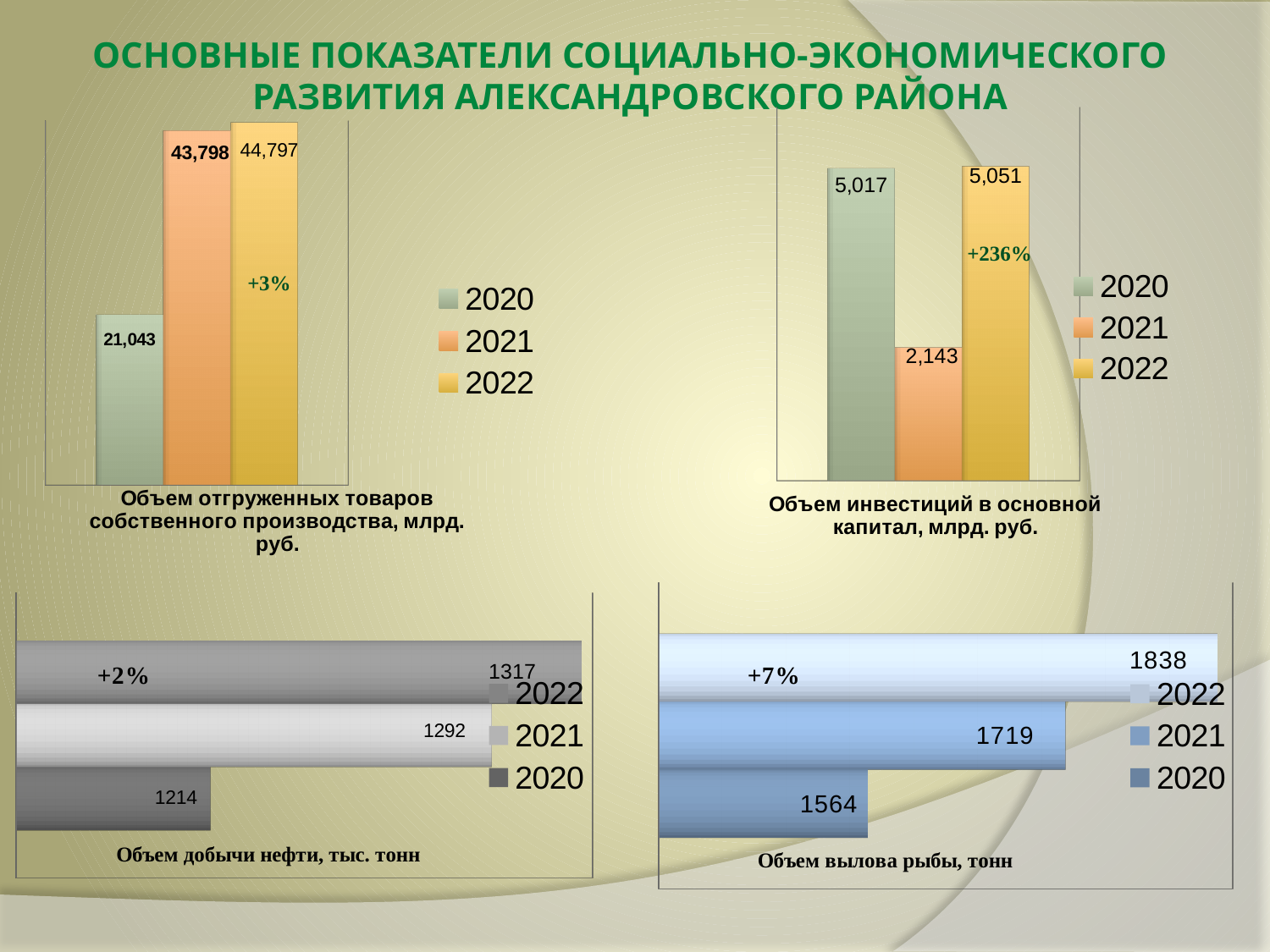
In the chart 'Объем добычи нефти, тыс. тонн', what is the value for 2020? 1214 In the chart 'Объем вылова рыбы, тонн', what is the value for 2022? 1838 In the chart 'Объем добычи нефти, тыс. тонн', what is the difference between the 2022 and 2021 values? 25 What kind of chart is 'Объем вылова рыбы, тонн'? bar chart In the chart 'Объем инвестиций в основной капитал, млрд. руб.', which year has the lowest value? 2021 In the chart 'Объем отгруженных товаров собственного производства, млрд. руб.', what is the value for 2021? 43,798 In the chart 'Объем вылова рыбы, тонн', what is the difference between the 2021 and 2020 values? 155 In the chart 'Объем инвестиций в основной капитал, млрд. руб.', what percentage change is annotated on the 2022 bar? +236% In the chart 'Объем отгруженных товаров собственного производства, млрд. руб.', which year has the lowest value? 2020 In the chart 'Объем вылова рыбы, тонн', which is larger, the value for 2021 or the value for 2020? 2021 In the chart 'Объем инвестиций в основной капитал, млрд. руб.', what is the value for 2021? 2,143 In the chart 'Объем добычи нефти, тыс. тонн', do the values rise or fall from 2020 to 2022? rise